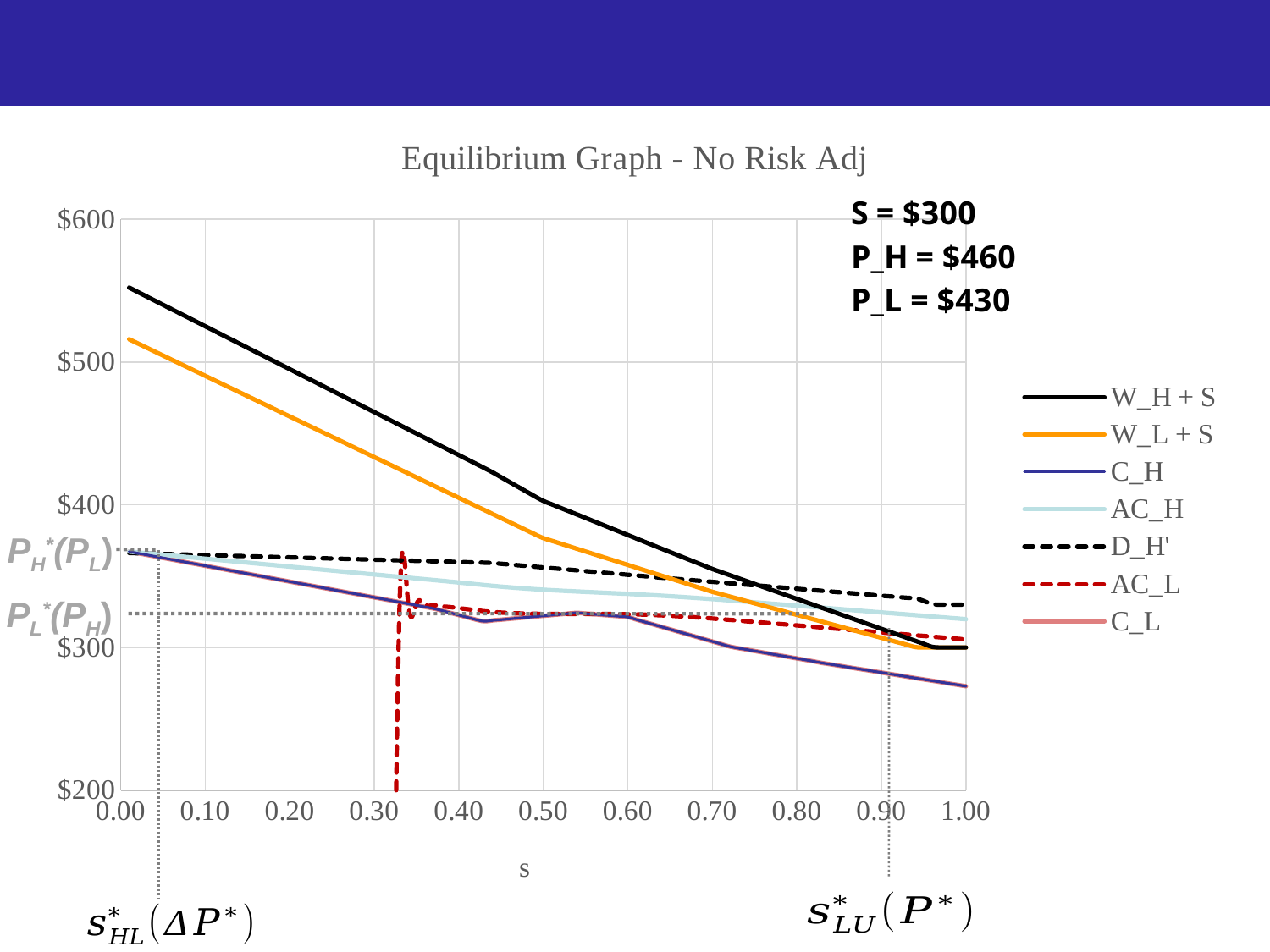
Which series has the highest value at s = 0.00? W_H + S Is the value of AC_H at s = 1.00 greater or less than $300? greater How many series does the chart's legend list? 7 At s = 0.20, which is larger, W_H + S or W_L + S? W_H + S Is the value of C_H at s = 1.00 greater or less than $300? less Is the value of W_H + S at s = 0.00 greater or less than $500? greater What kind of chart is shown on the slide? line chart What is the title of the chart? Equilibrium Graph - No Risk Adj Does the W_H + S series rise or fall as s increases from 0.00 to 1.00? fall What is the label of the x axis? s